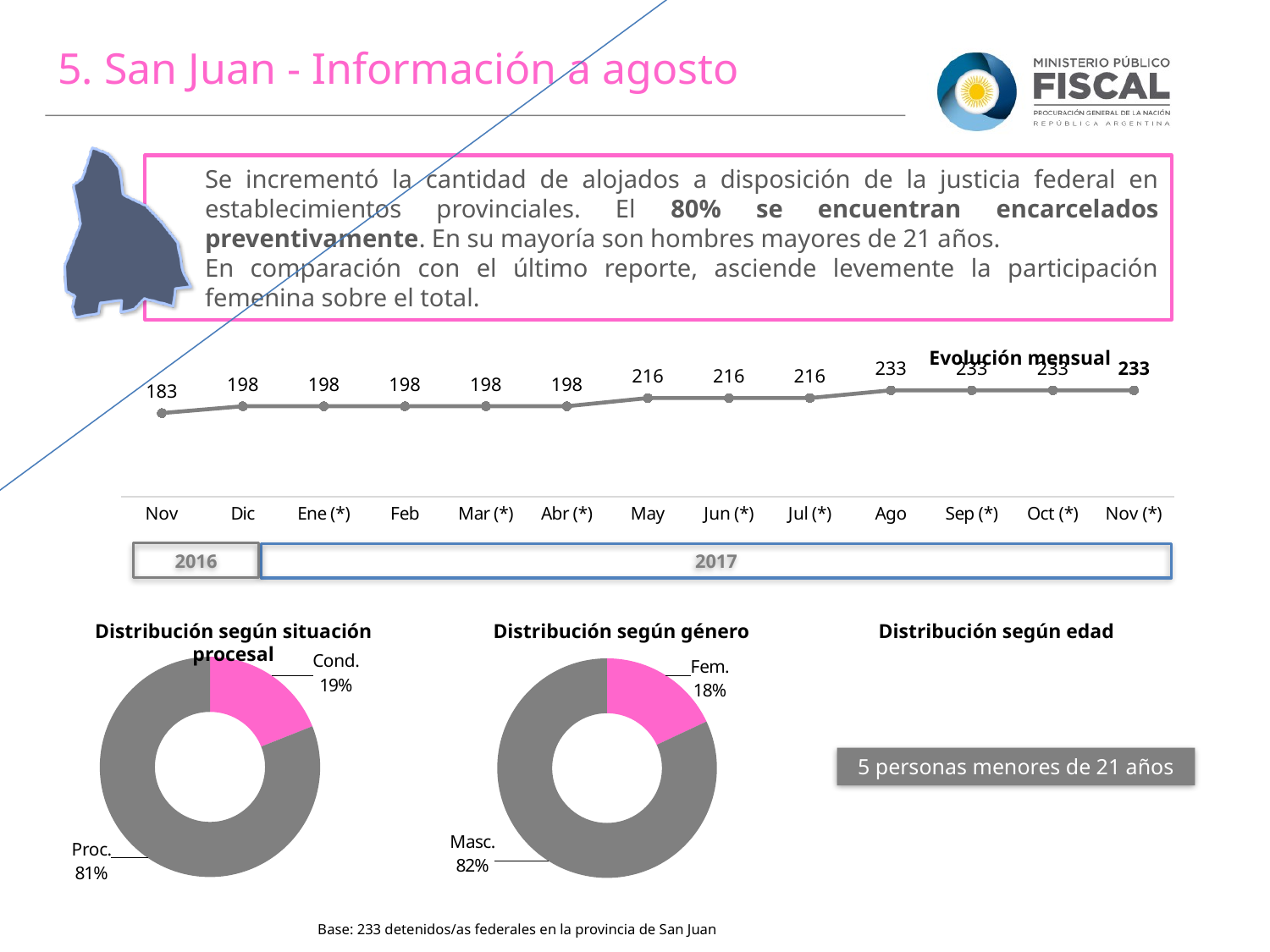
In the 'Evolución mensual' chart, what is the value for Nov 2016? 183 In the 'Evolución mensual' chart, do the values rise or fall from Nov 2016 to Nov (*) 2017? rise In the 'Evolución mensual' chart, what is the difference between the value for Ago and the value for Nov 2016? 50 In the 'Evolución mensual' chart, what is the value for Ago? 233 In the 'Distribución según género' chart, what share is Fem.? 18% What kind of chart is 'Evolución mensual'? line chart In the 'Distribución según género' chart, what is the difference between the Masc. share and the Fem. share? 64% In the 'Distribución según situación procesal' chart, which category is largest? Proc. In the 'Evolución mensual' chart, which month has the lowest value? Nov (2016) In the 'Distribución según situación procesal' chart, what share is Cond.? 19% How many data points are plotted in the 'Evolución mensual' chart? 13 In the 'Evolución mensual' chart, what is the value for May? 216